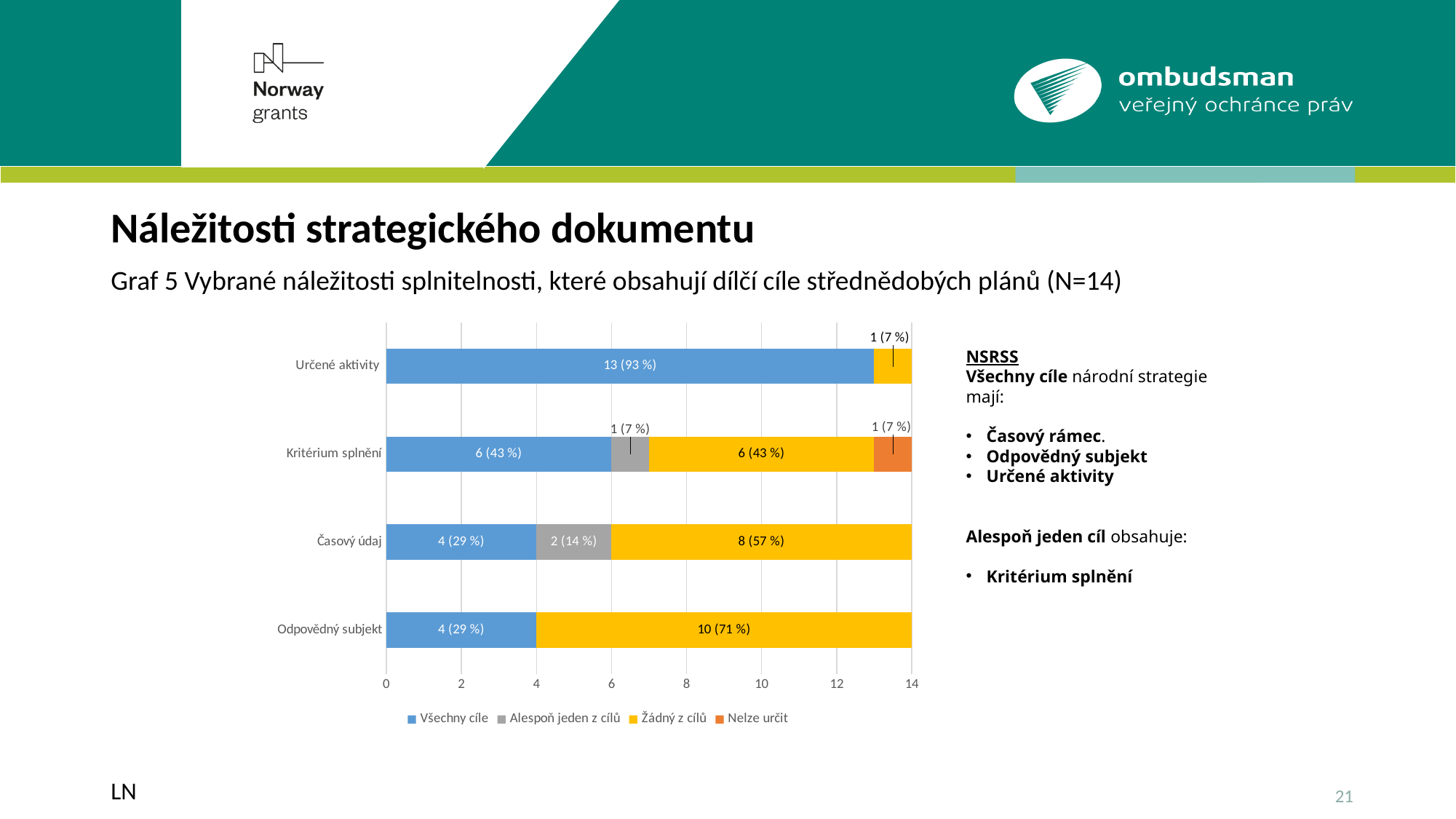
What is the total of the stacked bar for 'Kritérium splnění'? 14 What is the value of 'Nelze určit' for 'Kritérium splnění'? 1 (7 %) How many series does the chart legend list? 4 What is the value of 'Alespoň jeden z cílů' for 'Časový údaj'? 2 (14 %) What is the value of 'Všechny cíle' for 'Určené aktivity'? 13 (93 %) How many categories are shown on the vertical axis of the chart? 4 What is the value of 'Žádný z cílů' for 'Odpovědný subjekt'? 10 (71 %) What kind of chart is shown on the slide? stacked bar chart Which is larger: the 'Všechny cíle' value for 'Kritérium splnění' or for 'Časový údaj'? Kritérium splnění What is the difference between the 'Žádný z cílů' values for 'Odpovědný subjekt' and 'Časový údaj'? 2 Which category has the highest value for 'Všechny cíle'? Určené aktivity Which category has the lowest value for 'Žádný z cílů'? Určené aktivity